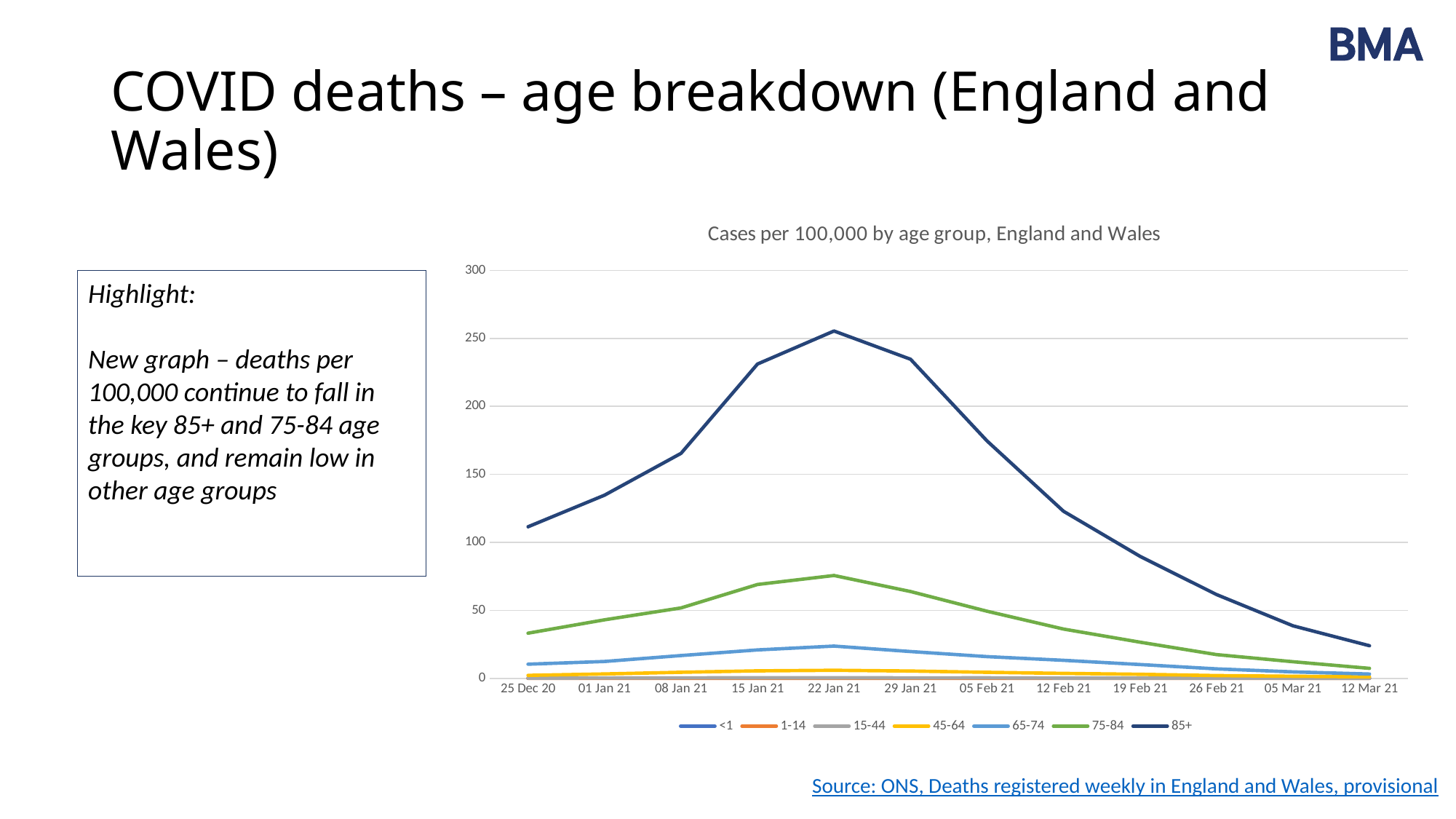
Is the value for the 85+ age group on 22 Jan 21 greater or less than 200? greater Does the 85+ line rise or fall between 22 Jan 21 and 12 Mar 21? Falls On which date does the 85+ line reach its peak? 22 Jan 21 How many dates are shown along the x axis of the chart? 12 What is the title of the chart? Cases per 100,000 by age group, England and Wales How many series does the chart legend list? 7 Is the value for the 65-74 age group on 22 Jan 21 greater or less than 50? less Is the value for the 75-84 age group on 22 Jan 21 greater or less than 50? greater Which age group has the highest values throughout the chart? 85+ What kind of chart is shown on the slide? Line chart On 22 Jan 21, which age group has the larger value: 85+ or 75-84? 85+